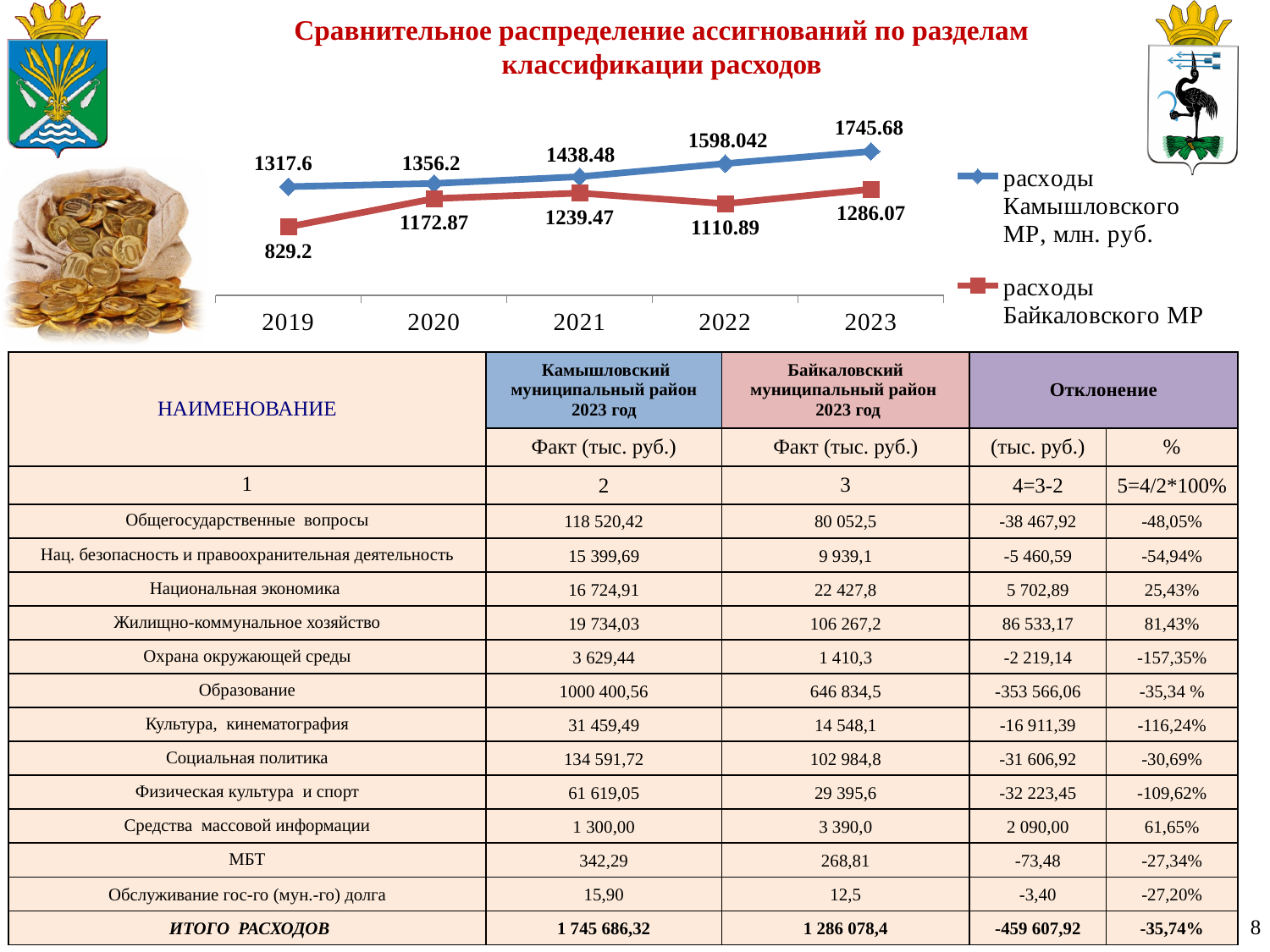
What is the value for расходы Камышловского МР in 2022? 1598.042 In which year is расходы Байкаловского МР lowest? 2019 What is the value for расходы Камышловского МР in 2023? 1745.68 Which series has the larger value in 2020, расходы Камышловского МР or расходы Байкаловского МР? расходы Камышловского МР What type of chart is shown on the slide? line chart What is the value for расходы Байкаловского МР in 2019? 829.2 What is the value for расходы Байкаловского МР in 2021? 1239.47 How many years are plotted along the x axis of the chart? 5 How many series does the chart legend list? 2 In which year is расходы Камышловского МР highest? 2023 What is the difference between расходы Камышловского МР and расходы Байкаловского МР in 2023? 459.61 Do the values for расходы Камышловского МР rise or fall from 2019 to 2023? rise